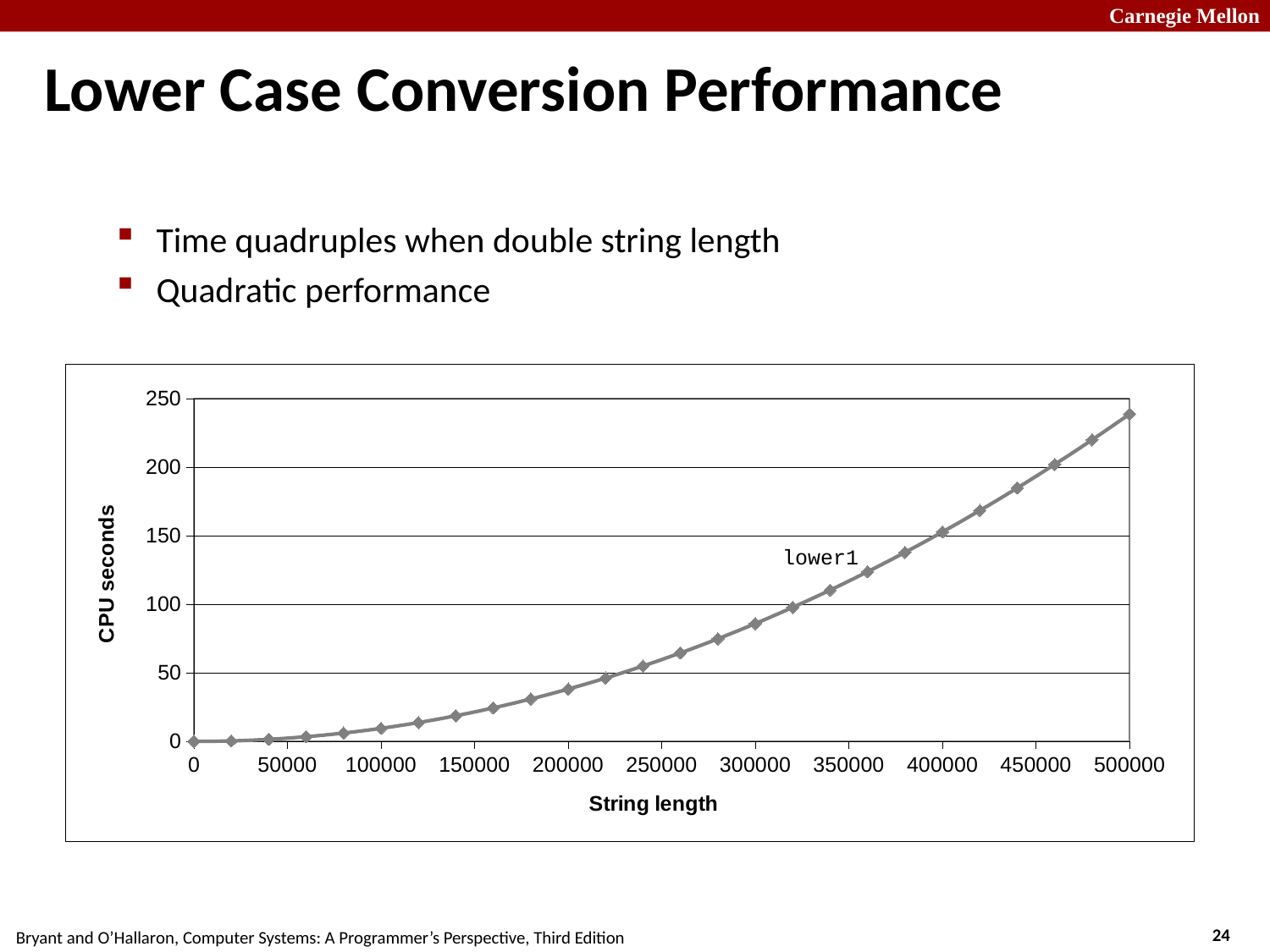
Is the value for string length 500000 greater or less than 200? greater Do the CPU seconds rise or fall as string length increases? rise What kind of chart is shown on the slide? line chart Is the value for string length 300000 greater or less than 100? less At which string length shown on the x axis is the CPU time highest? 500000 Is the value for string length 200000 greater or less than 50? less What is the label of the series plotted in the chart? lower1 Which has the larger CPU time, string length 400000 or string length 200000? 400000 How many data points are plotted on the line? 26 What is the label of the y axis? CPU seconds